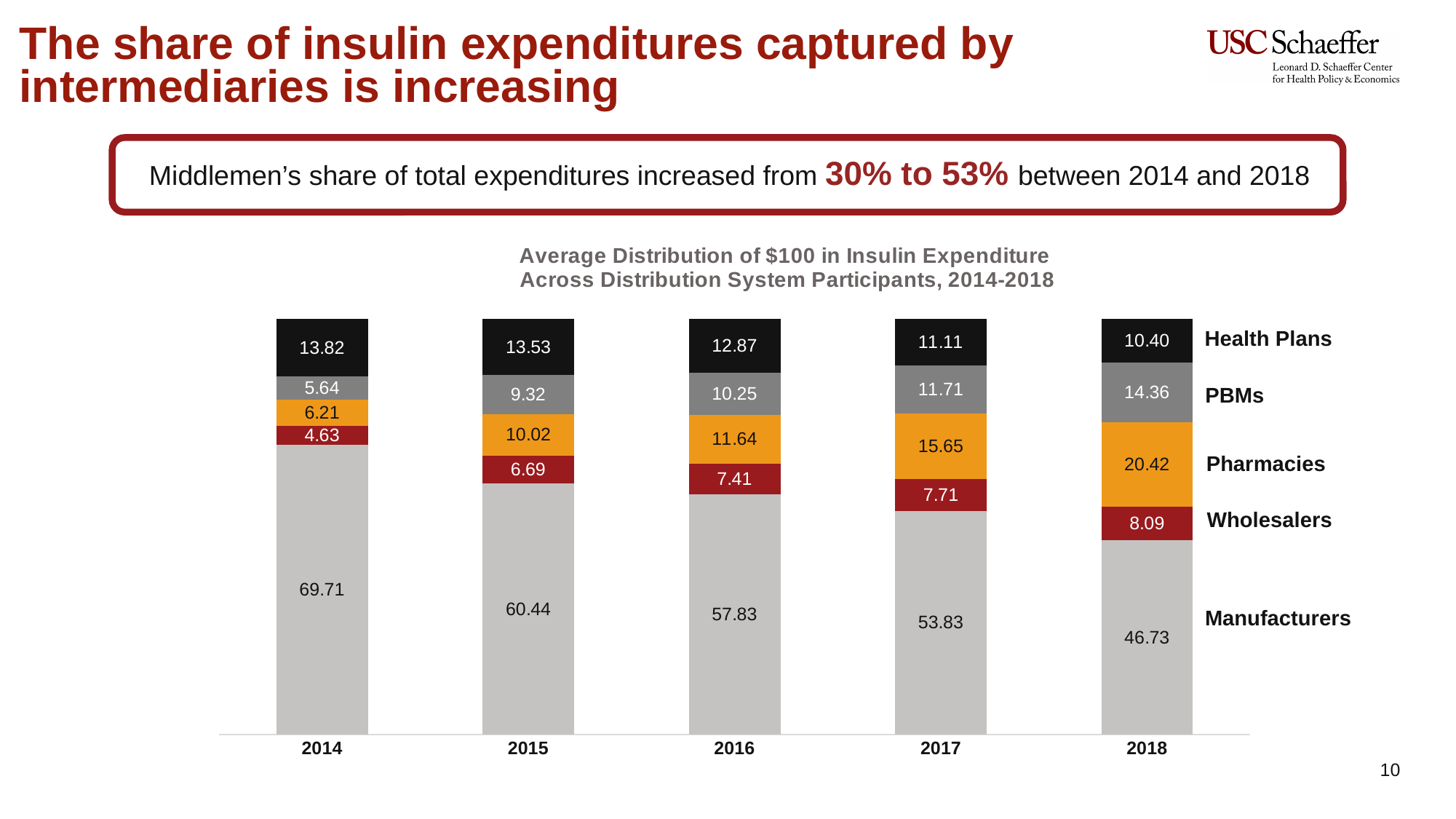
What is the Manufacturers value for 2014? 69.71 How much larger is the Manufacturers value in 2014 than in 2018? 22.98 What is the Pharmacies value for 2016? 11.64 Which is larger, the PBMs value in 2017 or the Health Plans value in 2017? PBMs (11.71) What type of chart is shown on the slide? Stacked bar chart What is the PBMs value for 2018? 14.36 How many participant categories (series) are stacked in each bar? 5 What is the Wholesalers value for 2017? 7.71 In which year is the Manufacturers value lowest? 2018 How many years are shown on the x axis? 5 In which year is the Health Plans value highest? 2014 Does the Pharmacies value rise or fall from 2014 to 2018? Rise